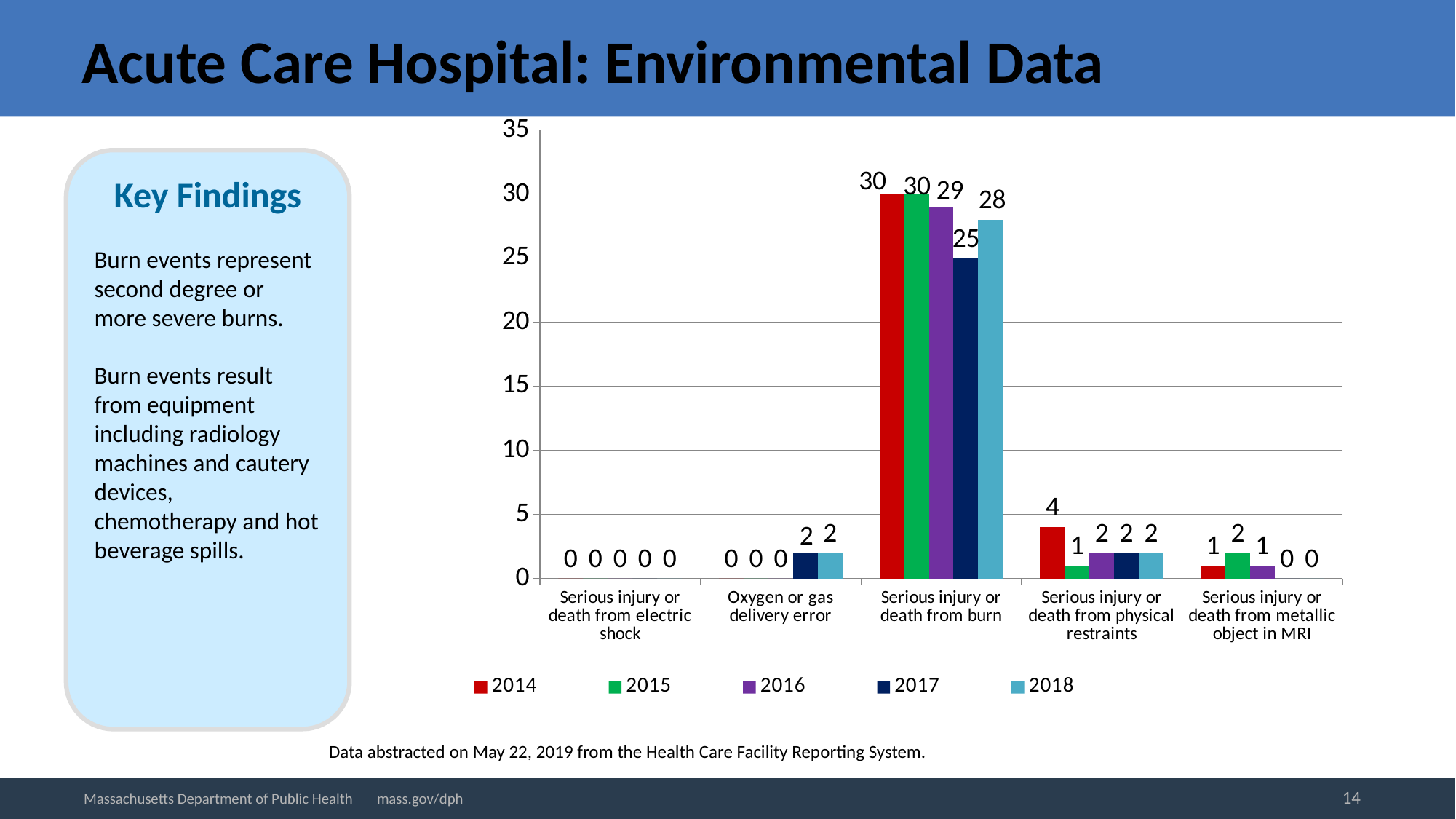
What is the value for 2018 in the 'Serious injury or death from burn' category? 28 Which year has the lowest value in the 'Serious injury or death from burn' category? 2017 What is the value for 2014 in the 'Serious injury or death from physical restraints' category? 4 Which colour represents 2017 in the legend? dark navy blue What is the value for 2015 in the 'Serious injury or death from metallic object in MRI' category? 2 What is the difference between the 2014 and 2017 values in the 'Serious injury or death from burn' category? 5 How many series does the legend list? 5 How many categories are shown on the x axis? 5 Which category has the highest values across all years? Serious injury or death from burn Is the 2014 value for 'Serious injury or death from physical restraints' larger or smaller than the 2015 value in the same category? larger What kind of chart is shown on the slide? bar chart What is the value for 2017 in the 'Oxygen or gas delivery error' category? 2